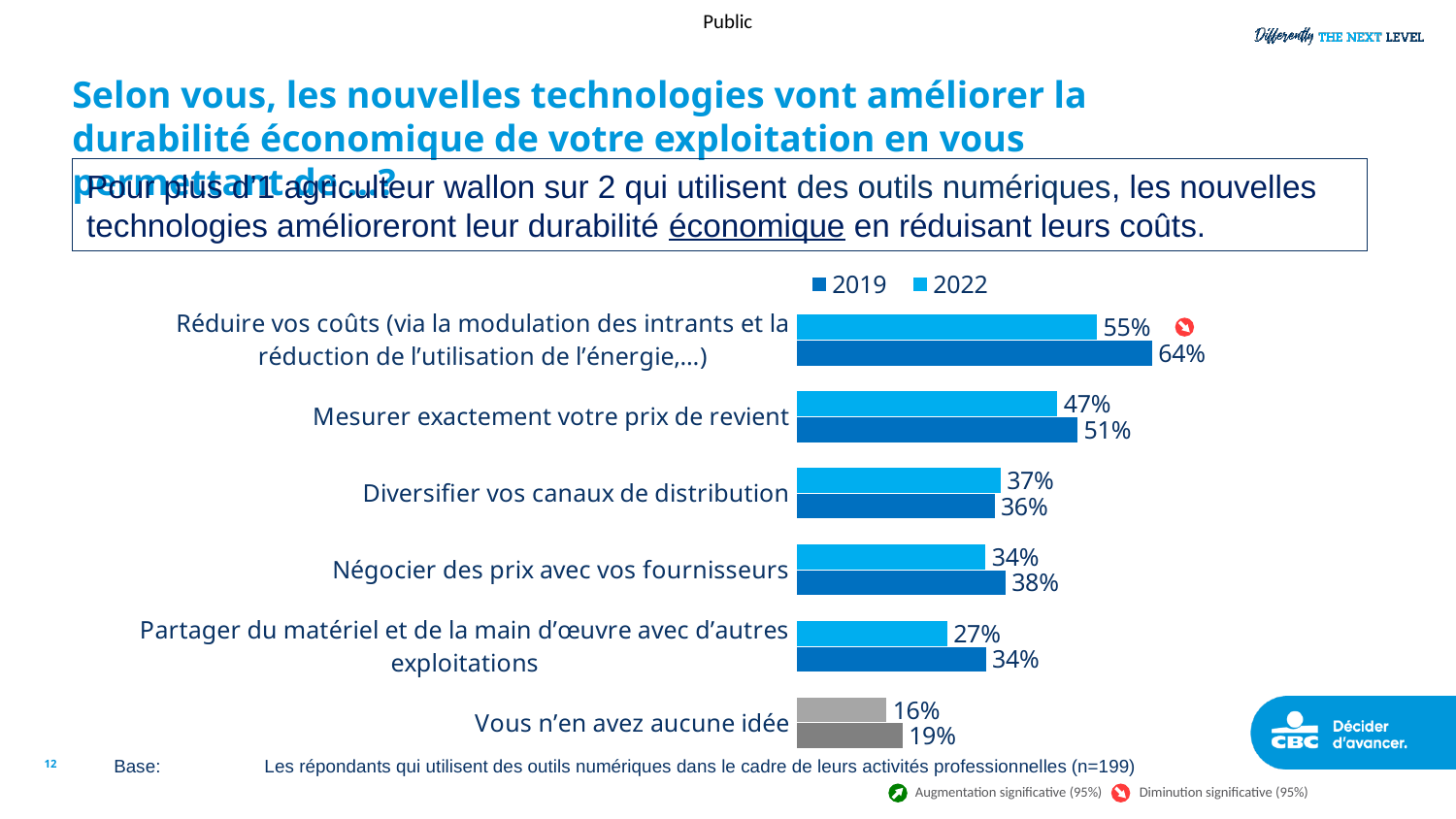
Which category has the lowest 2019 value? Vous n'en avez aucune idée How many categories are shown in the chart? 6 What is the 2022 value for 'Réduire vos coûts (via la modulation des intrants et la réduction de l'utilisation de l'énergie,…)'? 55% Which is larger for 'Mesurer exactement votre prix de revient': the 2019 value or the 2022 value? 2019 What is the difference between the 2019 and 2022 values for 'Négocier des prix avec vos fournisseurs'? 4% What is the 2019 value for 'Réduire vos coûts (via la modulation des intrants et la réduction de l'utilisation de l'énergie,…)'? 64% Which category has the highest 2022 value? Réduire vos coûts (via la modulation des intrants et la réduction de l'utilisation de l'énergie,…) What kind of chart is shown on the slide? bar chart What is the 2019 value for 'Partager du matériel et de la main d'œuvre avec d'autres exploitations'? 34% How many series does the chart legend list? 2 What is the 2022 value for 'Mesurer exactement votre prix de revient'? 47% Which years are listed in the chart legend? 2019 and 2022